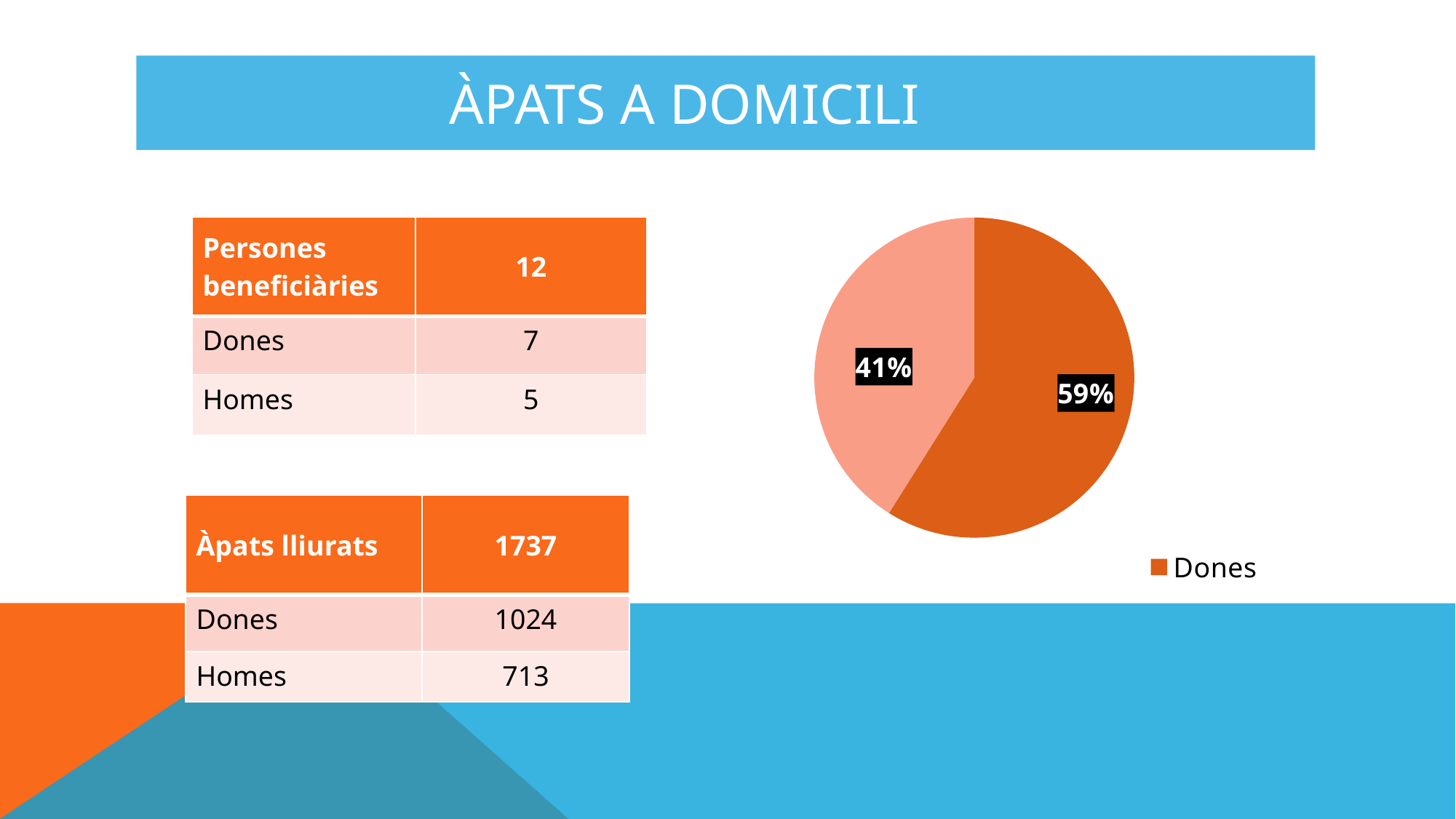
What percentage is shown on the smaller slice of the pie chart? 41% What is the difference in percentage points between the two slices of the pie chart? 18 What is the only entry shown in the pie chart's legend? Dones What is the title of the slide containing the pie chart? ÀPATS A DOMICILI What percentage is shown on the larger slice of the pie chart? 59% Which is larger in the pie chart, the Dones slice or the other slice? Dones What share of the pie chart does the Dones slice represent? 59% Is the share of the Dones slice greater or less than 50%? greater How many slices does the pie chart have? 2 How many entries does the pie chart's legend list? 1 Which slice of the pie chart is the largest? Dones What kind of chart is shown on the slide? pie chart